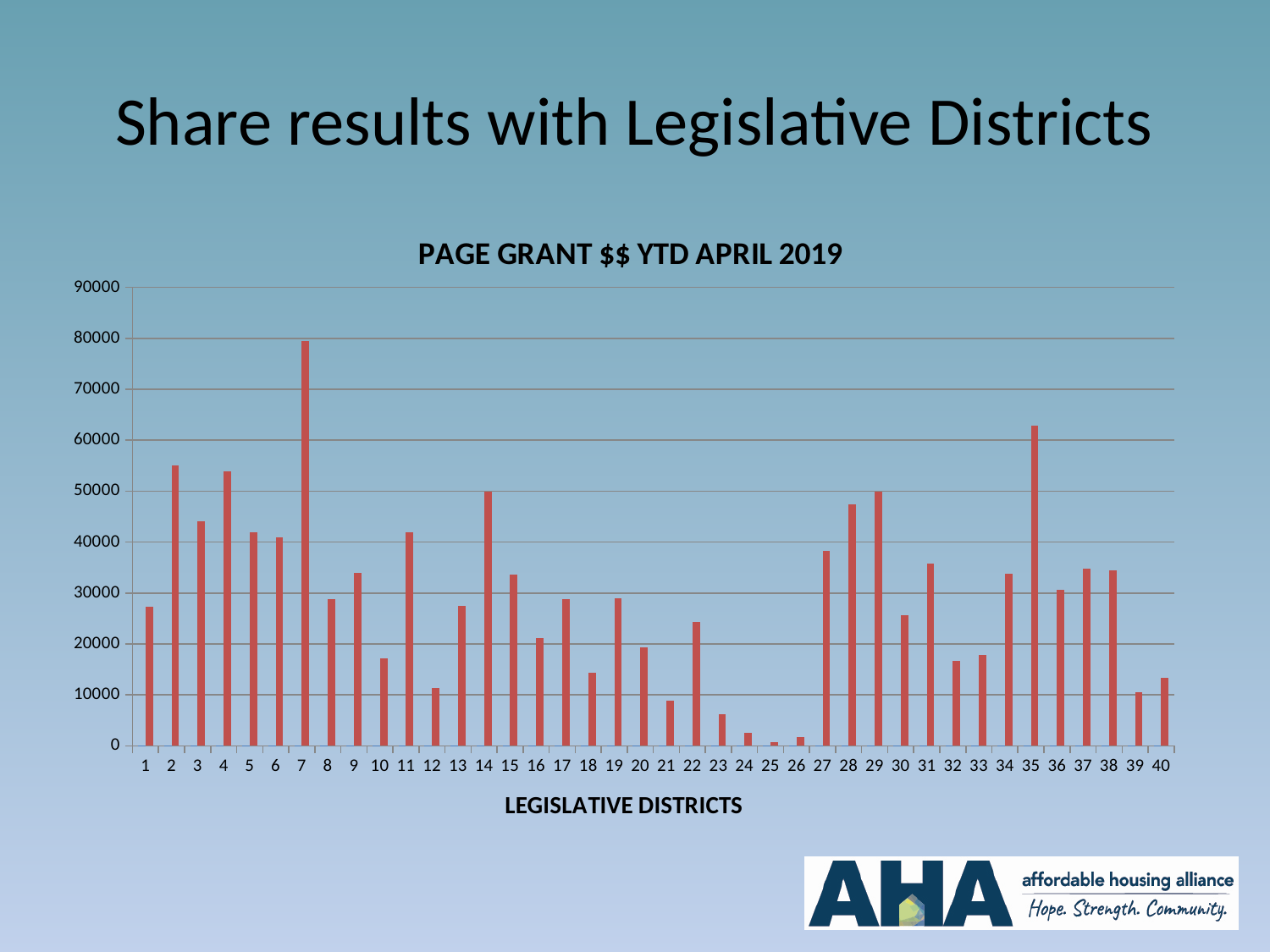
What is the label on the x axis of the chart? LEGISLATIVE DISTRICTS What kind of chart is shown on the slide? Bar chart How many legislative districts are plotted on the chart? 40 Which has the larger value, legislative district 2 or legislative district 3? 2 Which legislative district has the highest value on the chart? 7 Is the value for legislative district 24 greater or less than 10000? less Which has the larger value, legislative district 21 or legislative district 22? 22 Is the value for legislative district 1 greater or less than 20000? greater What is the title of the chart? PAGE GRANT $$ YTD APRIL 2019 Is the value for legislative district 7 greater or less than 70000? greater Which legislative district has the lowest value on the chart? 25